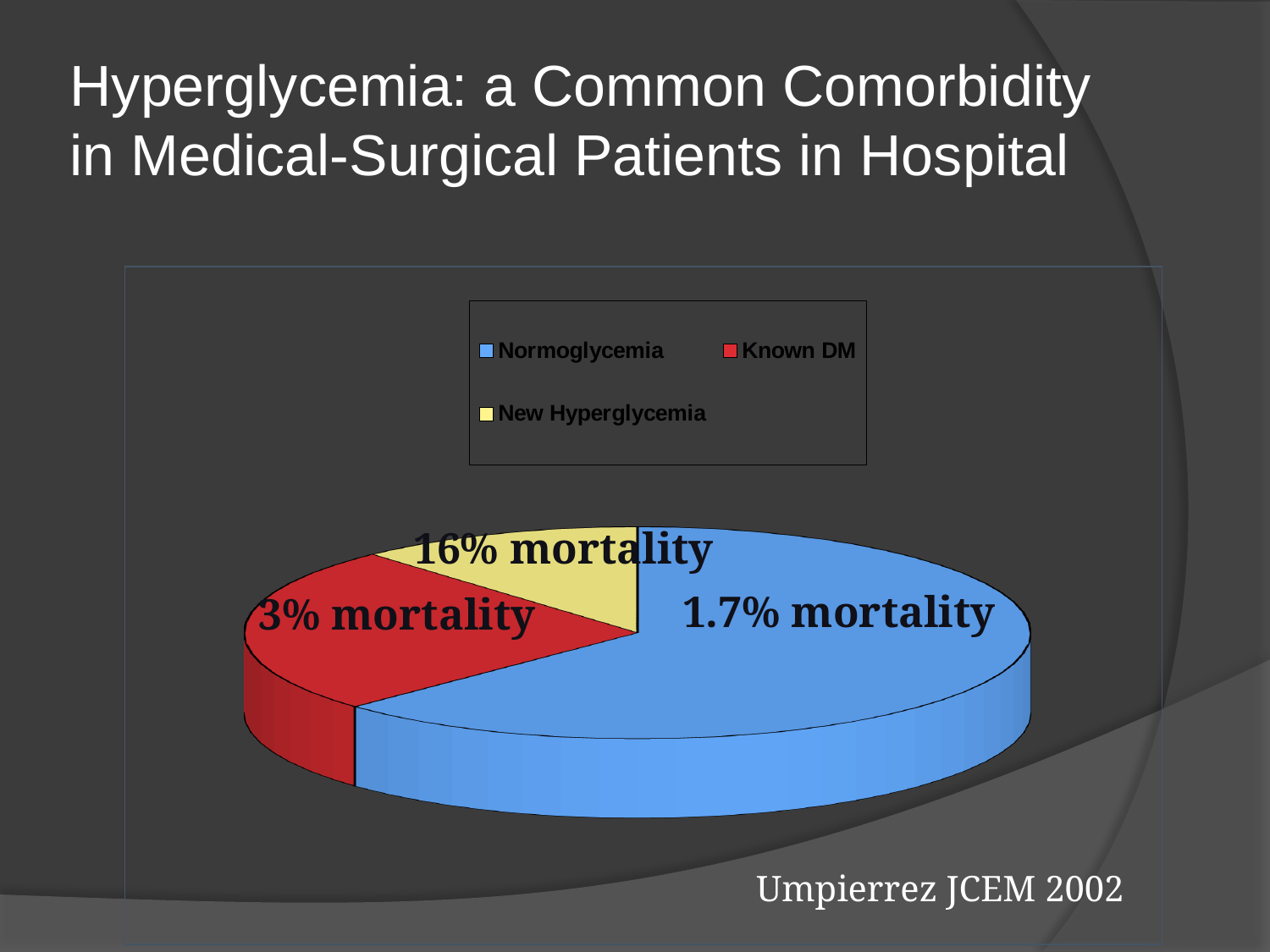
How many slices does the pie chart have? 3 What mortality label is printed on the New Hyperglycemia slice? 16% mortality What colour is the Known DM slice in the pie chart? red What kind of chart is shown on the slide? pie chart How many entries does the legend of the pie chart list? 3 What mortality label is printed on the Known DM slice? 3% mortality Which category has the largest slice of the pie chart? Normoglycemia Which slice is larger in the pie chart, Known DM or New Hyperglycemia? Known DM Which category has the smallest slice of the pie chart? New Hyperglycemia Which slice is larger in the pie chart, Normoglycemia or Known DM? Normoglycemia What source citation is shown below the pie chart? Umpierrez JCEM 2002 What mortality label is printed on the Normoglycemia slice? 1.7% mortality